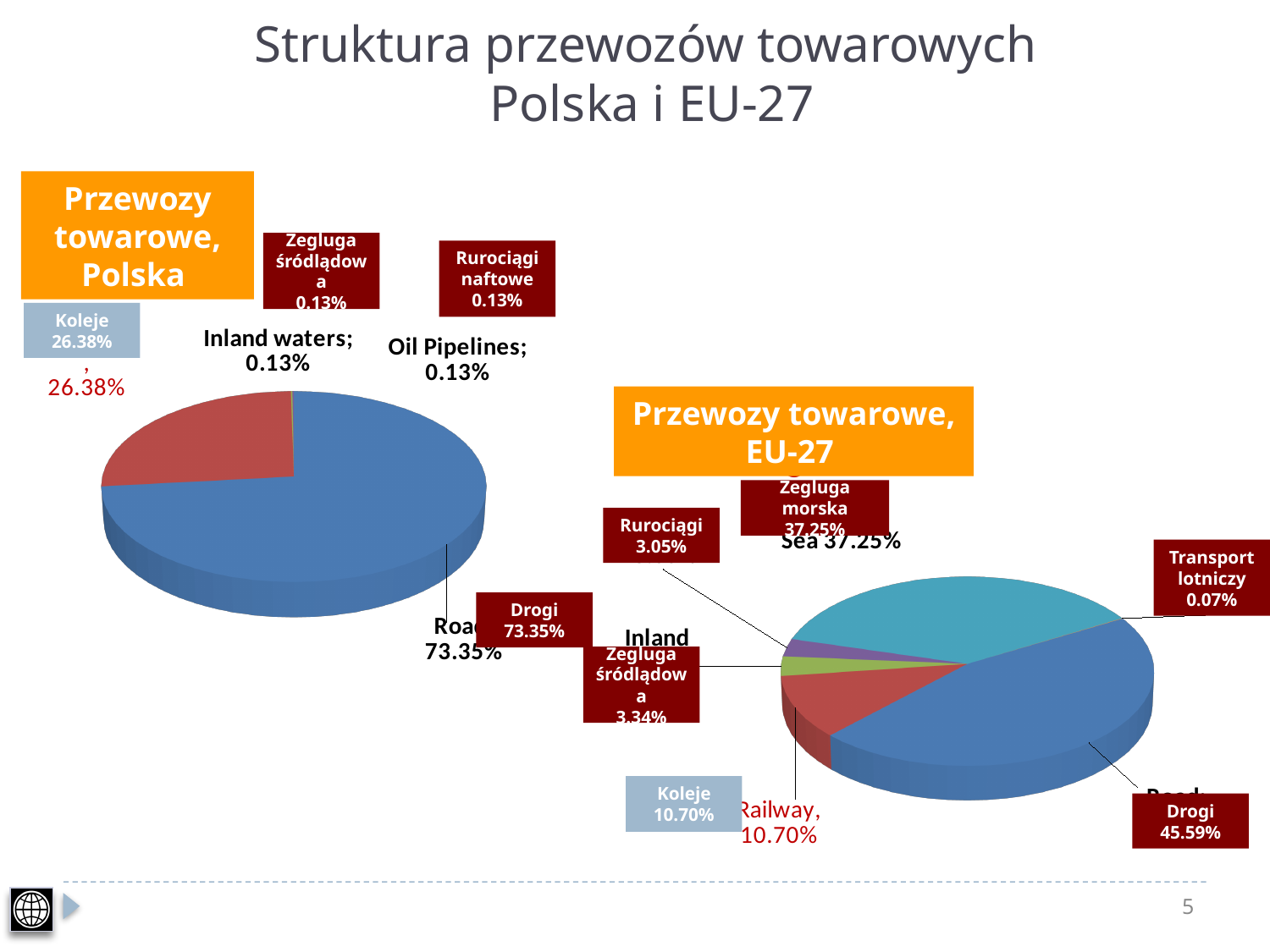
In the 'Przewozy towarowe, EU-27' pie chart, which category has the largest share? Drogi In the 'Przewozy towarowe, Polska' pie chart, what is the value for Drogi? 73.35% In the 'Przewozy towarowe, EU-27' pie chart, which is larger: Rurociągi or Żegluga śródlądowa? Żegluga śródlądowa In the 'Przewozy towarowe, Polska' pie chart, what is the value for Koleje? 26.38% In the 'Przewozy towarowe, EU-27' pie chart, what is the difference between Drogi and Żegluga morska? 8.34% In the 'Przewozy towarowe, Polska' pie chart, what is the difference between Drogi and Koleje? 46.97% In the 'Przewozy towarowe, EU-27' pie chart, what is the value for Żegluga morska? 37.25% In the 'Przewozy towarowe, EU-27' pie chart, what is the value for Koleje? 10.70% What type of chart is used for 'Przewozy towarowe, Polska'? Pie chart How many categories are shown in the 'Przewozy towarowe, EU-27' pie chart? 6 In the 'Przewozy towarowe, Polska' pie chart, which category has the largest share? Drogi In the 'Przewozy towarowe, EU-27' pie chart, which category has the smallest share? Transport lotniczy